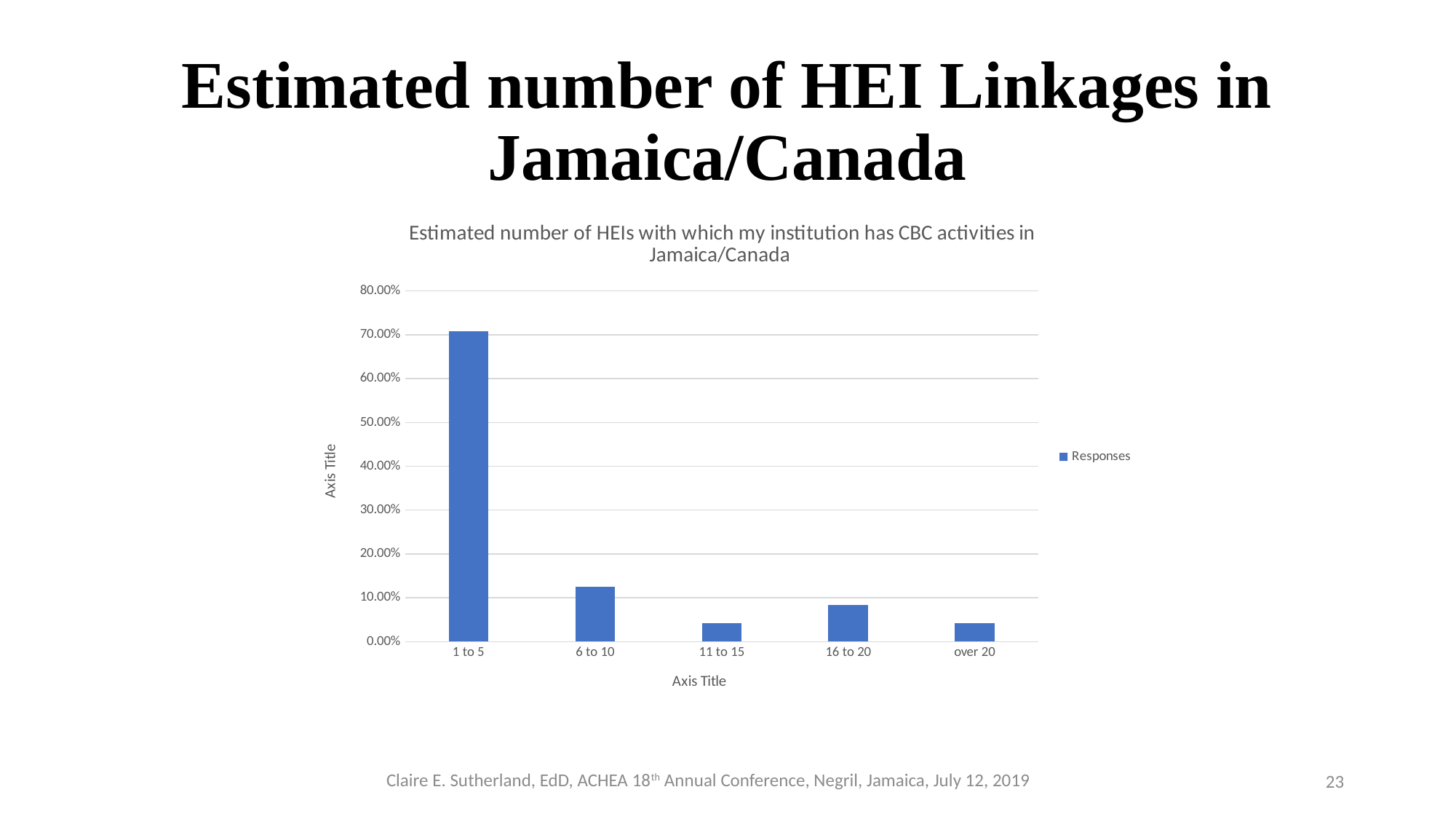
Is the value for over 20 greater or less than 10.00%? less How many series does the legend list? 1 Is the value for 6 to 10 greater or less than 10.00%? greater How many categories are shown on the x axis of the chart? 5 Which is larger, the value for 1 to 5 or the value for 6 to 10? 1 to 5 Which category has the highest value in the chart? 1 to 5 Is the value for 16 to 20 greater or less than 10.00%? less Which is larger, the value for 6 to 10 or the value for 16 to 20? 6 to 10 What is the name of the series shown in the legend? Responses What kind of chart is shown on the slide? Bar chart